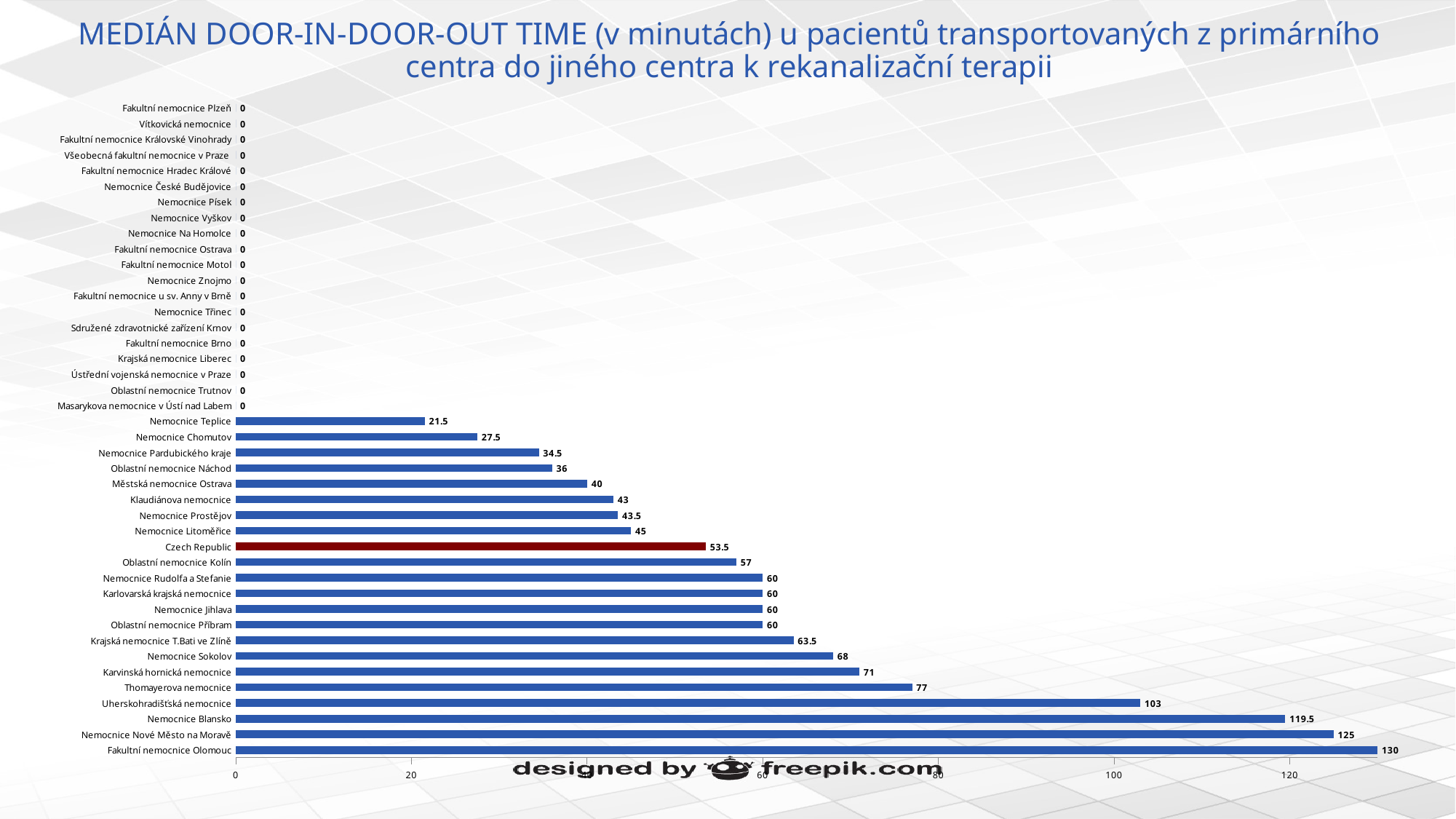
Which category is shown with a dark red bar instead of a blue one? Czech Republic Which hospital has the highest median door-in-door-out time? Fakultní nemocnice Olomouc What is the median door-in-door-out time for Czech Republic? 53.5 What is the value shown for Nemocnice Blansko? 119.5 Is the value for Krajská nemocnice T.Bati ve Zlíně greater or less than 60? greater What is the difference between the values for Uherskohradišťská nemocnice and Thomayerova nemocnice? 26 What type of chart is shown on the slide? bar chart How many hospitals/categories are listed on the chart? 42 Which is larger, the value for Nemocnice Sokolov or the value for Karvinská hornická nemocnice? Karvinská hornická nemocnice What is the value shown for Nemocnice Teplice? 21.5 What is the value shown for Oblastní nemocnice Kolín? 57 What is the difference between the values for Fakultní nemocnice Olomouc and Nemocnice Nové Město na Moravě? 5